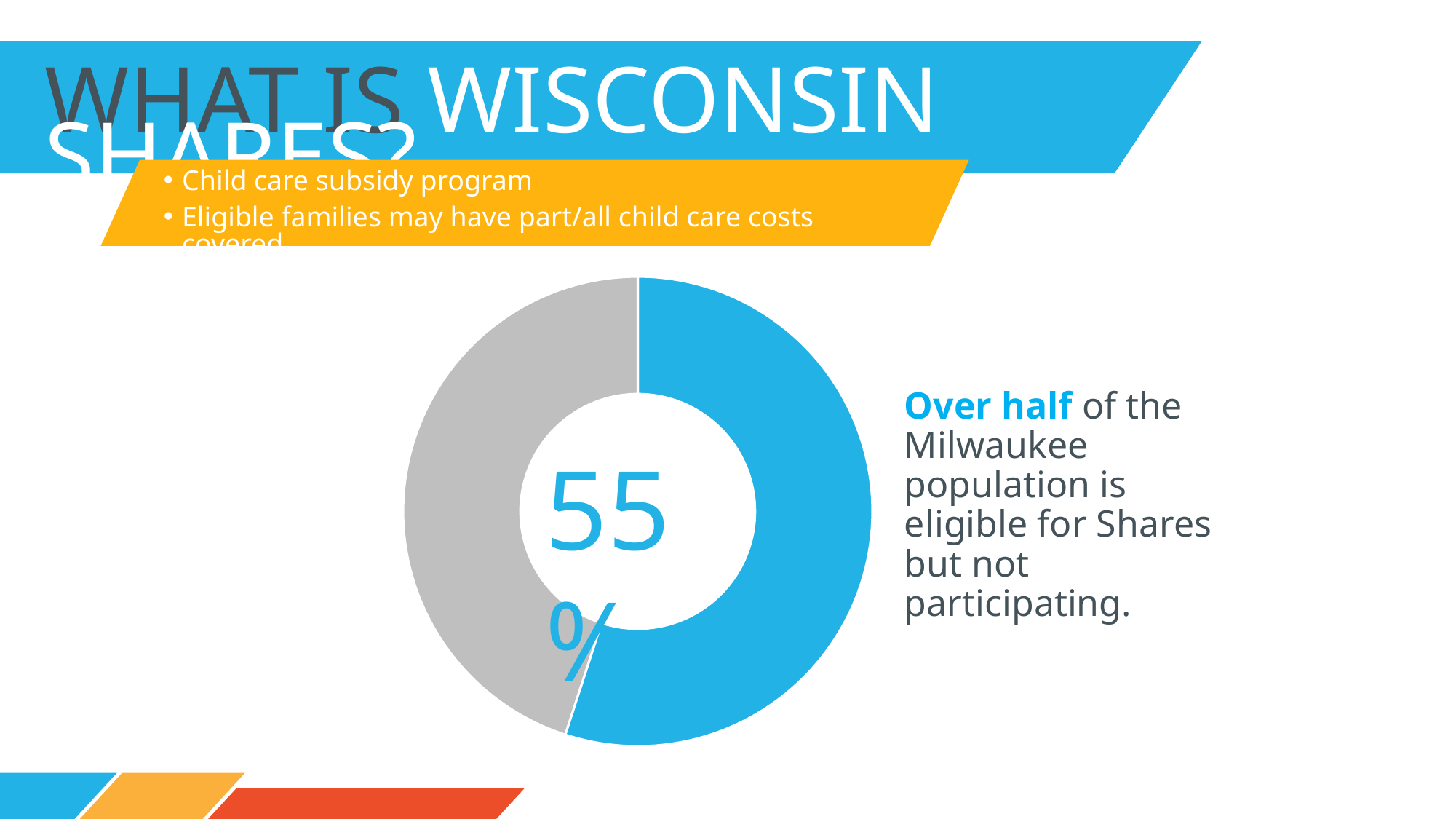
What share of the doughnut chart does the grey slice represent? 45% What two colours are used for the slices of the doughnut chart? Blue and grey What share of the doughnut chart does the blue slice represent? 55% How many slices does the doughnut chart have? 2 What kind of chart is shown on the slide? Doughnut (pie) chart According to the text beside the chart, what does the 55% slice represent? Milwaukee population eligible for Shares but not participating Which slice of the doughnut chart is larger, the blue one or the grey one? Blue What percentage is printed in the centre of the doughnut chart? 55% Is the blue slice of the doughnut chart more or less than half of the whole? More